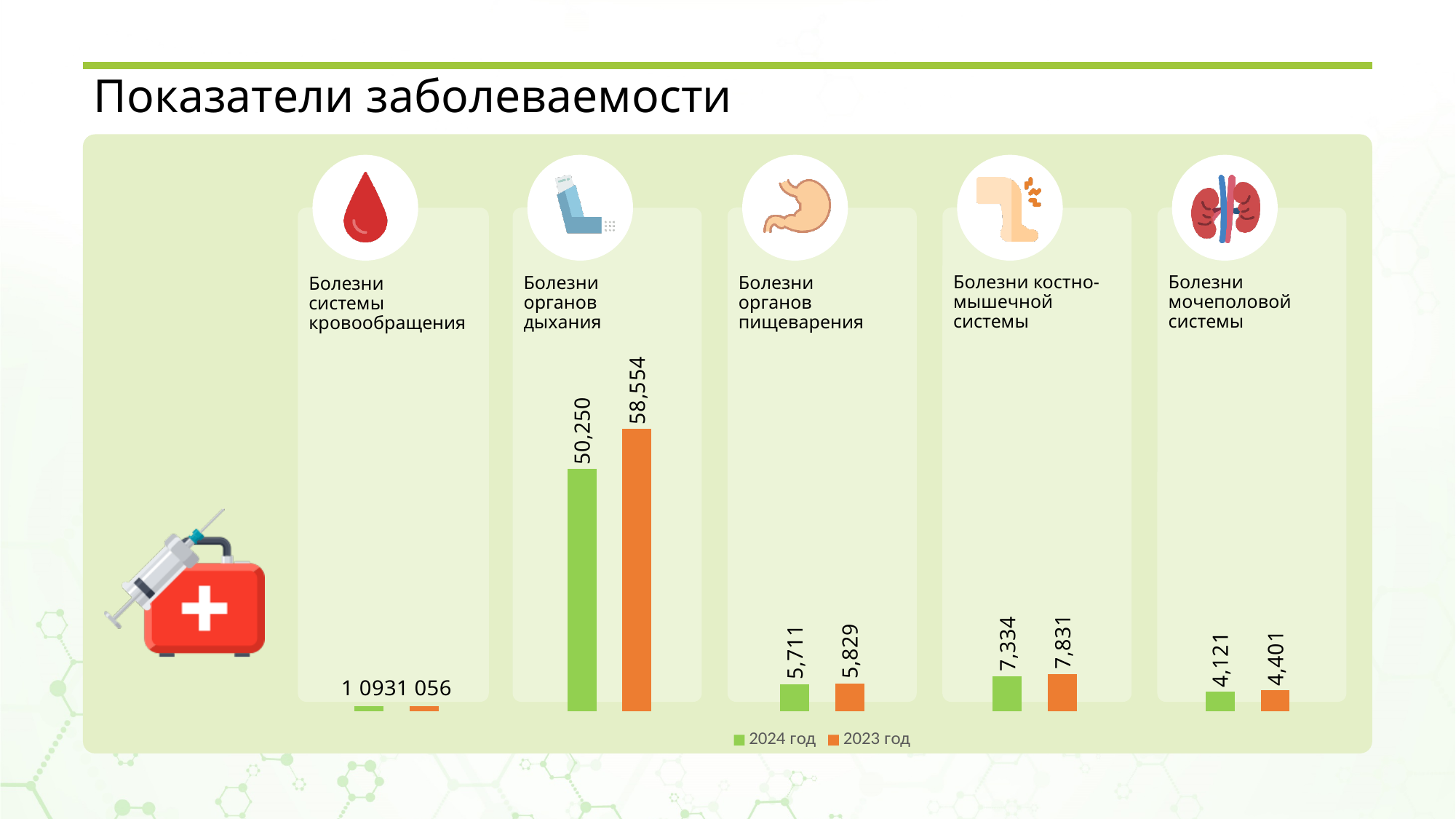
Which is larger for Болезни мочеполовой системы: the 2024 год value or the 2023 год value? 2023 год How many categories are shown in the chart? 5 What kind of chart is shown on the slide? Bar chart What is the value for 2024 год for Болезни органов пищеварения? 5,711 What is the value for 2024 год for Болезни органов дыхания? 50,250 What is the value for 2023 год for Болезни органов дыхания? 58,554 What is the difference between the 2023 год and 2024 год values for Болезни органов дыхания? 8,304 What is the value for 2023 год for Болезни костно-мышечной системы? 7,831 Which category has the lowest value for 2024 год? Болезни системы кровообращения How many series does the legend list? 2 What is the value for 2024 год for Болезни мочеполовой системы? 4,121 Which category has the highest value for 2023 год? Болезни органов дыхания